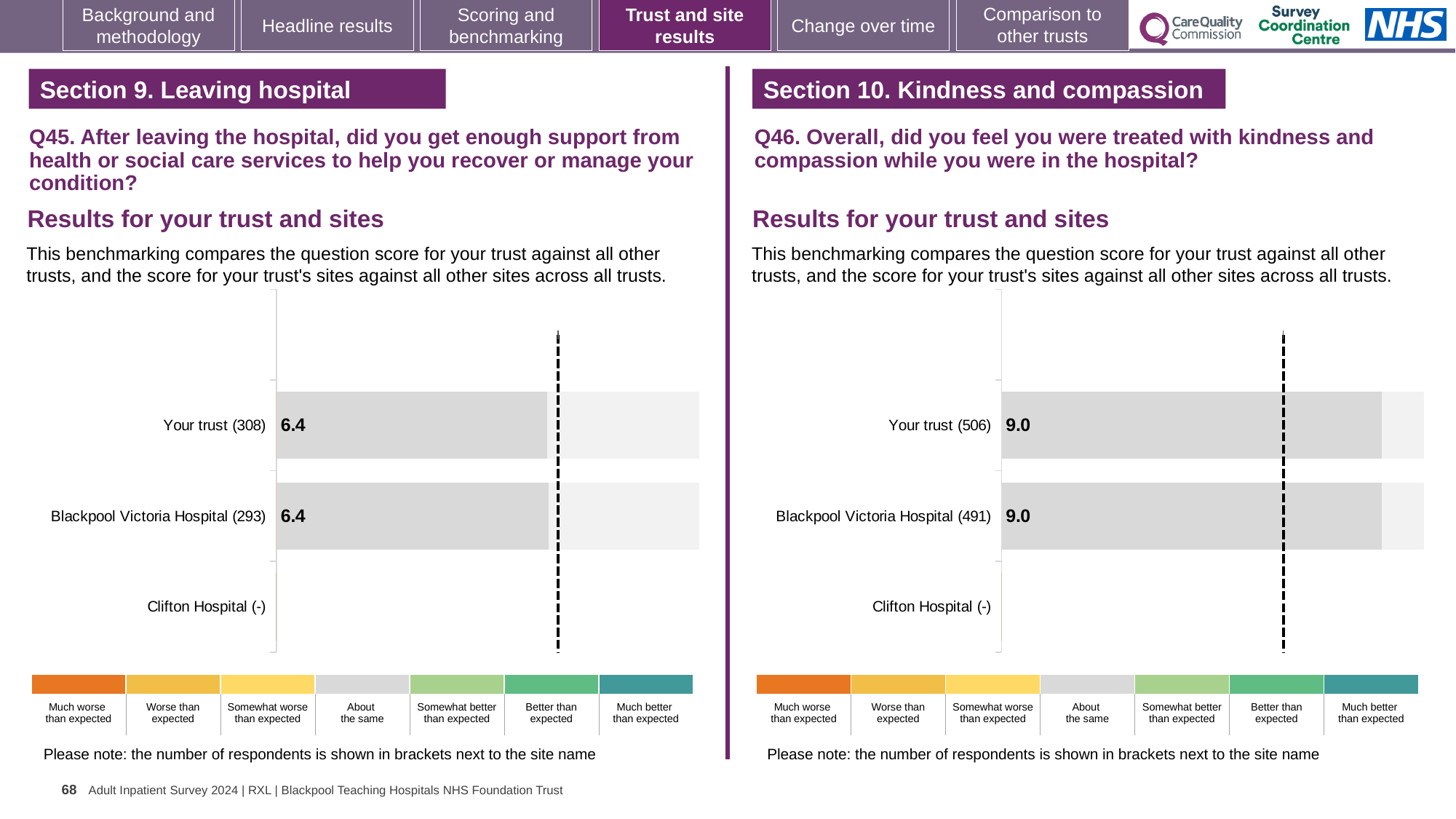
What type of chart is used on the Q45 chart (left)? Bar chart On the Q45 chart (left), what is the difference between the scores for Your trust and Blackpool Victoria Hospital? 0.0 How many categories does the colour key below the Q46 chart (right) list? 7 On the Q45 chart (left), which row has no score shown? Clifton Hospital On the Q45 chart (left), how many respondents are shown in brackets for Your trust? 308 On the Q46 chart (right), how many respondents are shown in brackets for Blackpool Victoria Hospital? 491 On the Q45 chart (left), what is the score for Blackpool Victoria Hospital? 6.4 On the Q46 chart (right), what is the score for Your trust? 9.0 On the Q45 chart (left), what is the score for Your trust? 6.4 On the Q46 chart (right), how many respondents are shown in brackets for Your trust? 506 On the Q46 chart (right), what is the score for Blackpool Victoria Hospital? 9.0 On the Q46 chart (right), how many site/trust rows are listed? 3